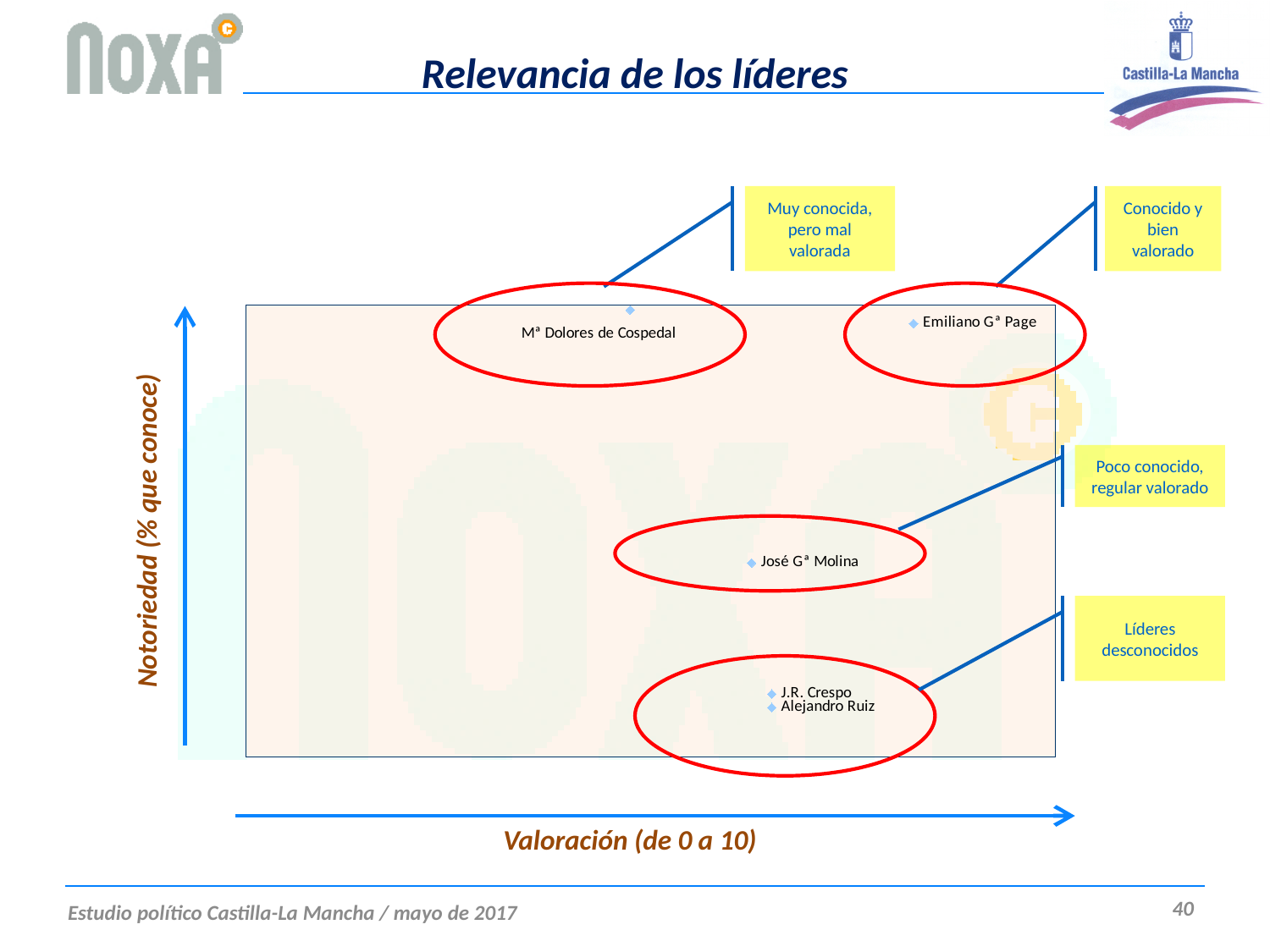
Who has a higher Valoración, José Gª Molina or Mª Dolores de Cospedal? José Gª Molina What label is on the vertical axis of the chart? Notoriedad (% que conoce) What is the title of the slide's chart? Relevancia de los líderes What kind of chart is shown on the slide? Scatter chart Who has a higher Notoriedad, Emiliano Gª Page or José Gª Molina? Emiliano Gª Page Which leader has the lowest Valoración (furthest left on the chart)? Mª Dolores de Cospedal Who has a higher Valoración, Emiliano Gª Page or Mª Dolores de Cospedal? Emiliano Gª Page How many leaders are plotted as points on the chart? 5 Which leader has the highest Valoración (furthest right on the chart)? Emiliano Gª Page